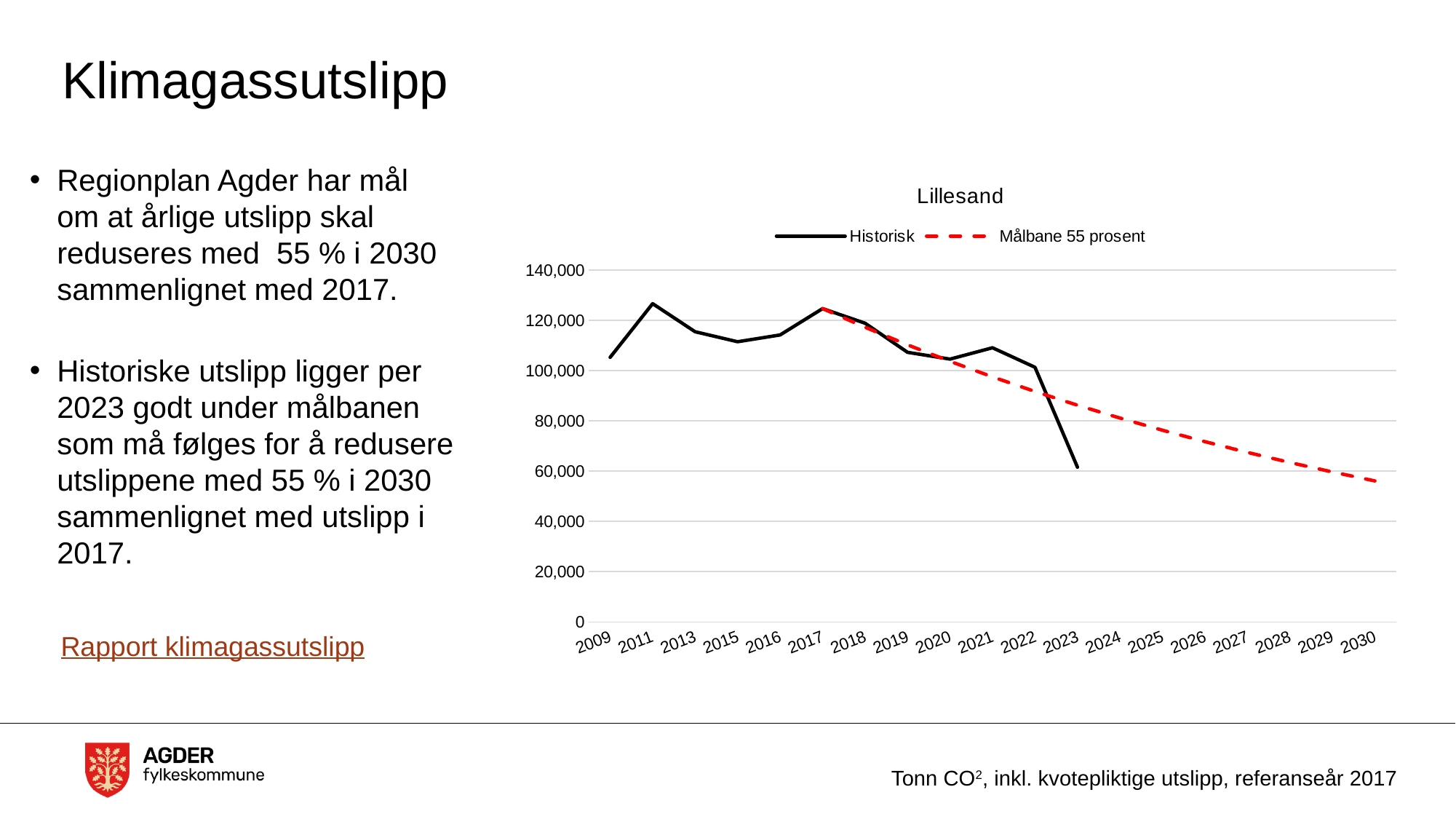
Does the Målbane 55 prosent series rise or fall from 2017 to 2030? Fall What are the two series named in the chart legend? Historisk and Målbane 55 prosent What is the title of the chart? Lillesand Is the Målbane 55 prosent value for 2030 greater or less than 60,000? less What kind of chart is shown on the slide? Line chart How many year labels are shown on the x axis of the chart? 19 In which year is the Historisk series at its lowest value? 2023 Is the Historisk value for 2023 greater or less than 80,000? less Which is larger, the Historisk value for 2022 or for 2023? 2022 How many series does the chart legend list? 2 Is the Historisk value for 2011 greater or less than 120,000? greater